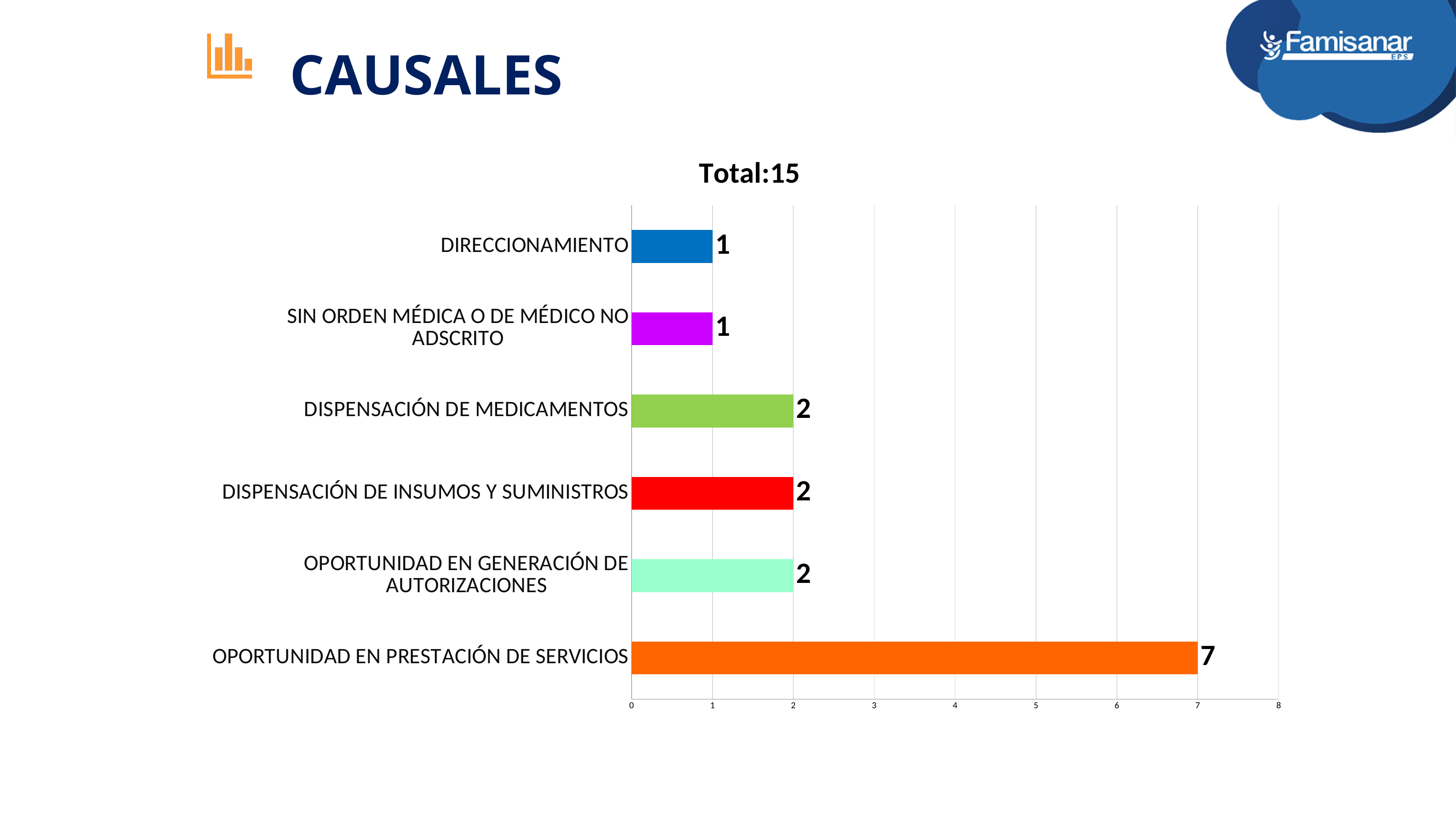
What is the value for OPORTUNIDAD EN PRESTACIÓN DE SERVICIOS? 7 What is the difference between the values for OPORTUNIDAD EN PRESTACIÓN DE SERVICIOS and DISPENSACIÓN DE INSUMOS Y SUMINISTROS? 5 How many categories are shown in the chart? 6 What is the value for SIN ORDEN MÉDICA O DE MÉDICO NO ADSCRITO? 1 What is the value for DIRECCIONAMIENTO? 1 Which category has the highest value? OPORTUNIDAD EN PRESTACIÓN DE SERVICIOS What kind of chart is shown on the slide? bar chart What is the title of the slide? CAUSALES Which is larger, the value for OPORTUNIDAD EN GENERACIÓN DE AUTORIZACIONES or the value for DIRECCIONAMIENTO? OPORTUNIDAD EN GENERACIÓN DE AUTORIZACIONES Is the value for OPORTUNIDAD EN PRESTACIÓN DE SERVICIOS greater or less than 5? greater What is the value for DISPENSACIÓN DE MEDICAMENTOS? 2 What total is printed above the chart? Total:15